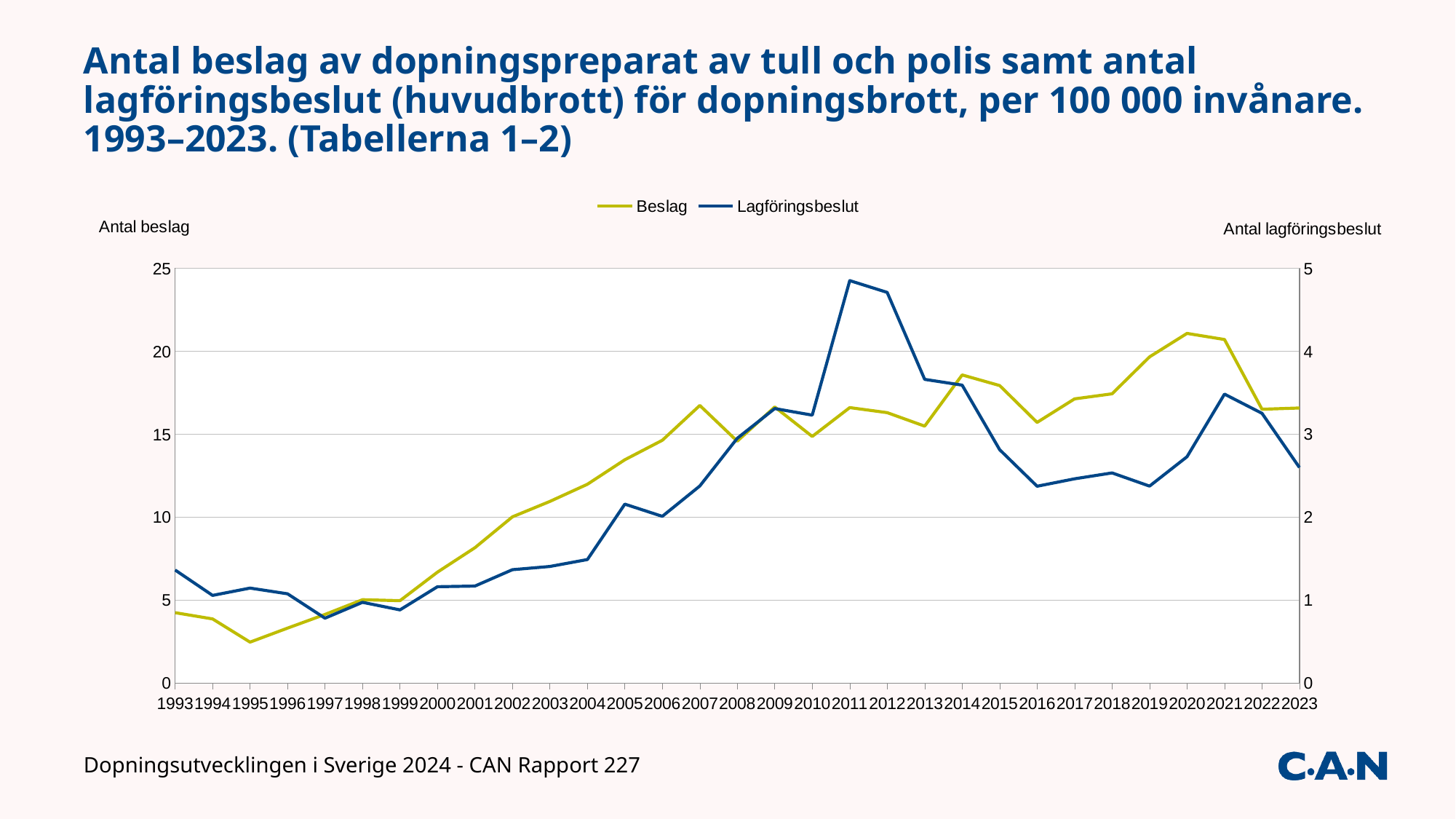
Is the Lagföringsbeslut value for 2011 greater or less than 4? greater Does the Beslag series rise or fall between 1995 and 2007? rise Is the Beslag value for 2020 greater or less than 20? greater Is the Lagföringsbeslut value for 2023 greater or less than 3? less What kind of chart is shown on the slide? line chart In which year does the Lagföringsbeslut series reach its highest value? 2011 Which colour is used for the Lagföringsbeslut line? blue In which year does the Beslag series reach its lowest value? 1995 How many series does the legend list? 2 How many years are plotted along the x axis? 31 In which year does the Beslag series reach its highest value? 2020